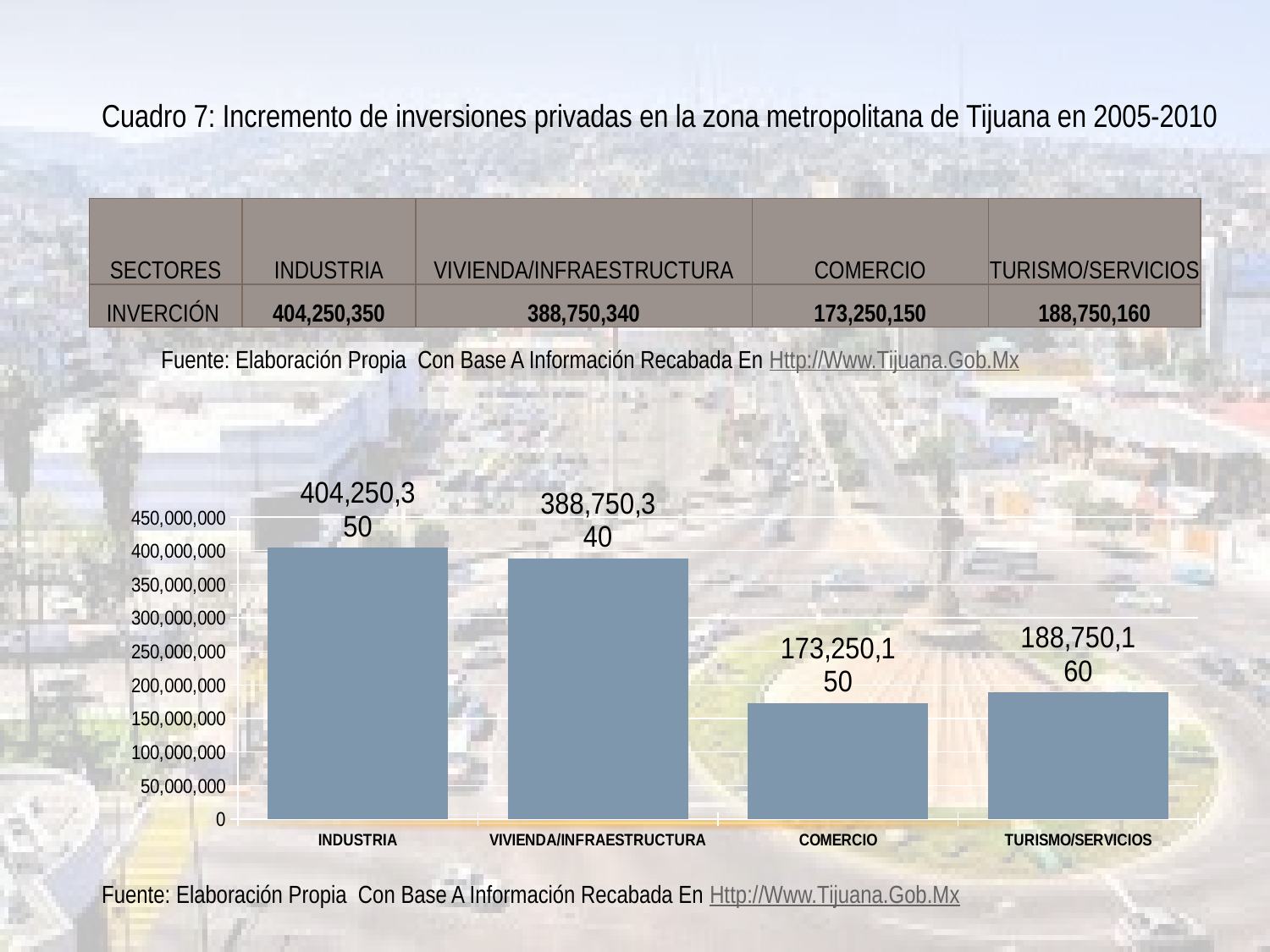
What is the difference between the values for TURISMO/SERVICIOS and COMERCIO? 15,500,010 Is the value for VIVIENDA/INFRAESTRUCTURA greater or less than 350,000,000? greater Which sector has the highest bar? INDUSTRIA What type of chart is shown on the slide? Bar chart Which sector has the lowest bar? COMERCIO What is the difference between the values for INDUSTRIA and VIVIENDA/INFRAESTRUCTURA? 15,500,010 What is the value of the bar for TURISMO/SERVICIOS? 188,750,160 What is the value of the bar for INDUSTRIA? 404,250,350 What is the value of the bar for COMERCIO? 173,250,150 How many sectors are shown as bars in the chart? 4 What is the value of the bar for VIVIENDA/INFRAESTRUCTURA? 388,750,340 Which is larger, the value for COMERCIO or the value for TURISMO/SERVICIOS? TURISMO/SERVICIOS